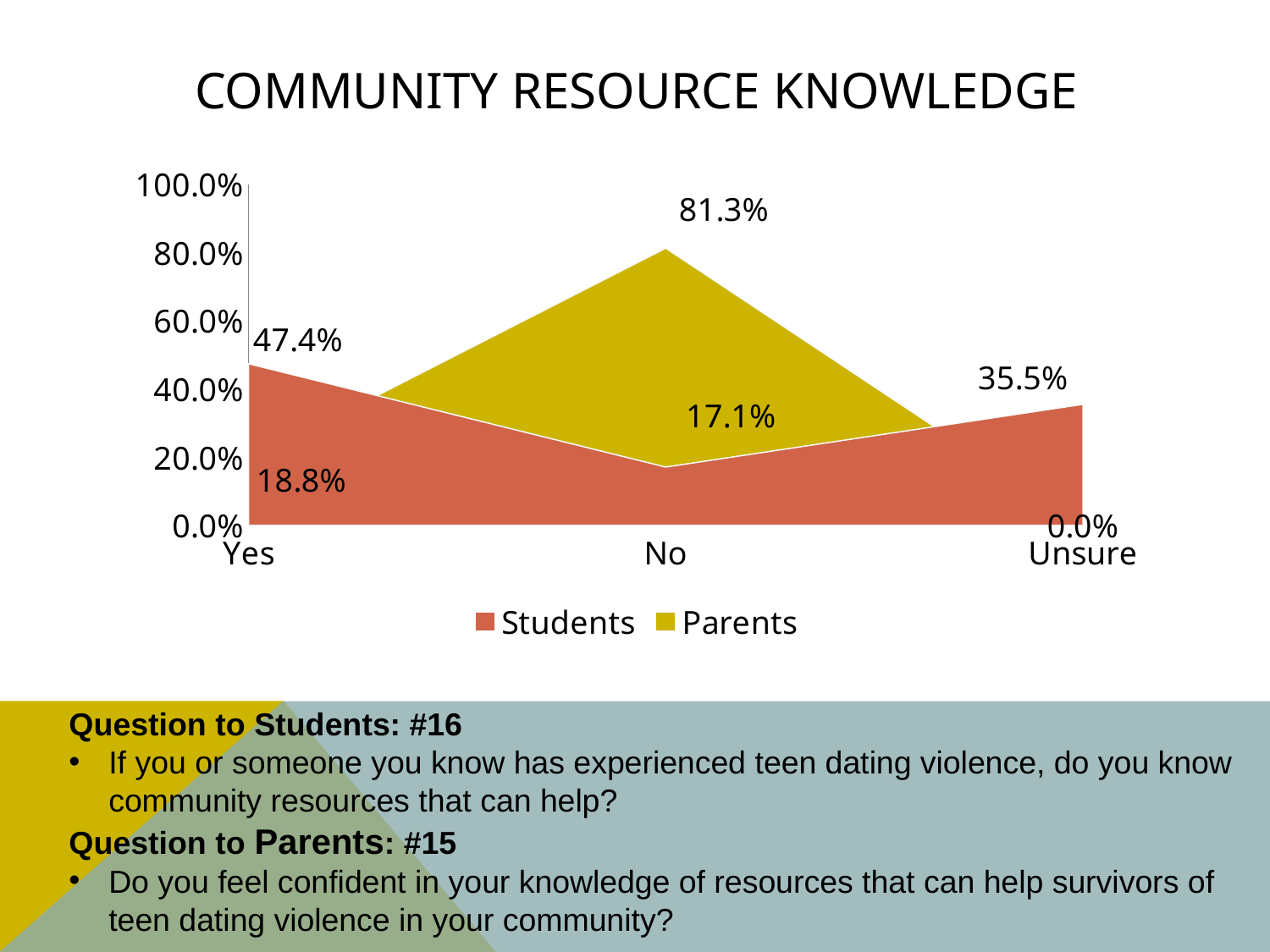
What kind of chart is shown on the slide? Area chart What is the Students value for No? 17.1% For which category is the Parents value highest? No What is the Parents value for Yes? 18.8% How many series does the legend list? 2 For which category is the Students value lowest? No For Yes, which series has the larger value, Students or Parents? Students What is the Students value for Unsure? 35.5% What is the Parents value for No? 81.3% What is the Students value for Yes? 47.4% What is the Parents value for Unsure? 0.0% What is the difference between the Parents and Students values for No? 64.2%